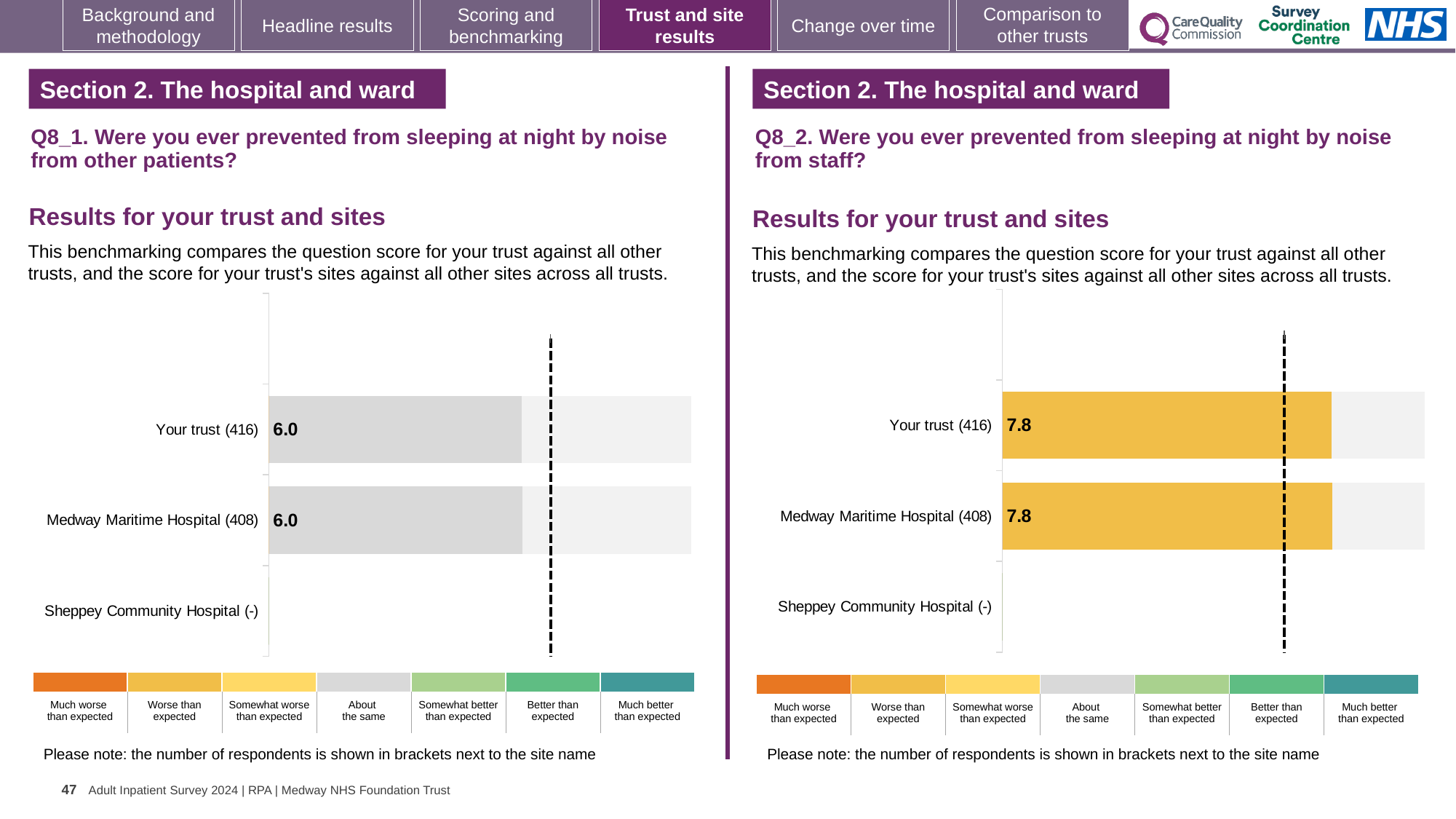
What is the difference between the Your trust (416) score in the Q8_2 chart and the Your trust (416) score in the Q8_1 chart? 1.8 In the Q8_1 chart (noise from other patients), what is the score for Medway Maritime Hospital (408)? 6.0 In the Q8_1 chart, what score is shown for Sheppey Community Hospital? No score is shown (no bar or value) How many benchmarking categories does the colour key below the Q8_2 chart list? 7 What kind of chart is used in the Q8_1 chart on the left? Bar chart In the Q8_2 chart (noise from staff), what is the score for Medway Maritime Hospital (408)? 7.8 In the Q8_1 chart, what is the difference between the score for Your trust (416) and Medway Maritime Hospital (408)? 0.0 In the Q8_1 chart (noise from other patients), what is the score for Your trust (416)? 6.0 In the Q8_2 chart (noise from staff), what is the score for Your trust (416)? 7.8 How many site/trust categories are listed on the y axis of the Q8_2 chart on the right? 3 Which is larger: the Your trust (416) score in the Q8_1 chart or the Your trust (416) score in the Q8_2 chart? Q8_2 chart According to the colour key, which benchmarking category do the yellow bars in the Q8_2 chart represent? Worse than expected